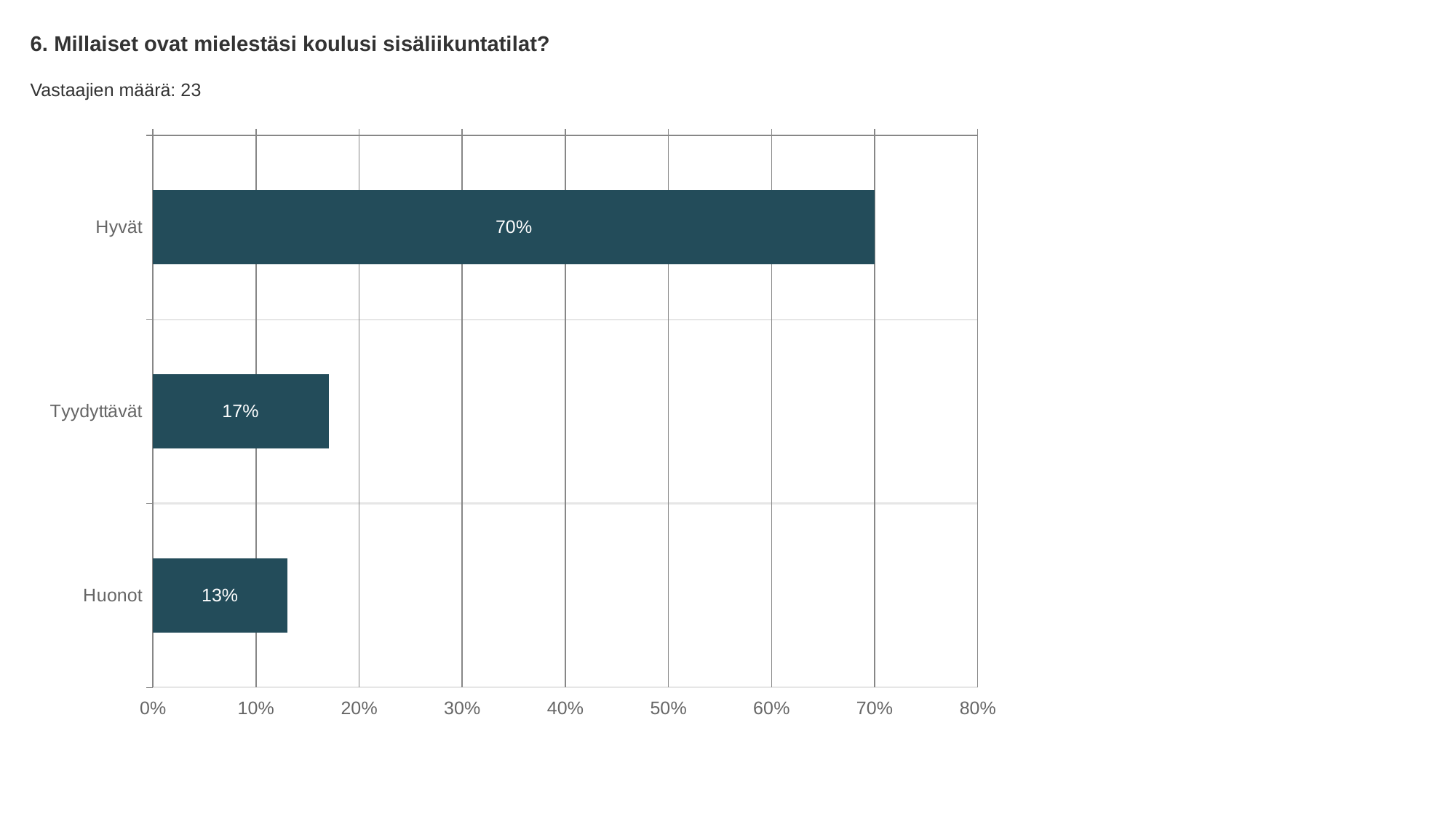
How many respondents (Vastaajien määrä) does the slide report? 23 What kind of chart is shown on the slide? Bar chart What percentage of respondents answered "Hyvät"? 70% What is the value shown for "Tyydyttävät"? 17% Which is larger, the value for "Hyvät" or the value for "Huonot"? Hyvät How many categories are shown in the chart? 3 What is the difference in percentage points between "Hyvät" and "Tyydyttävät"? 53 Is the value for "Hyvät" greater or less than 50%? greater Which category has the highest value? Hyvät What is the value shown for "Huonot"? 13% Which category has the lowest value? Huonot What is the difference in percentage points between "Tyydyttävät" and "Huonot"? 4